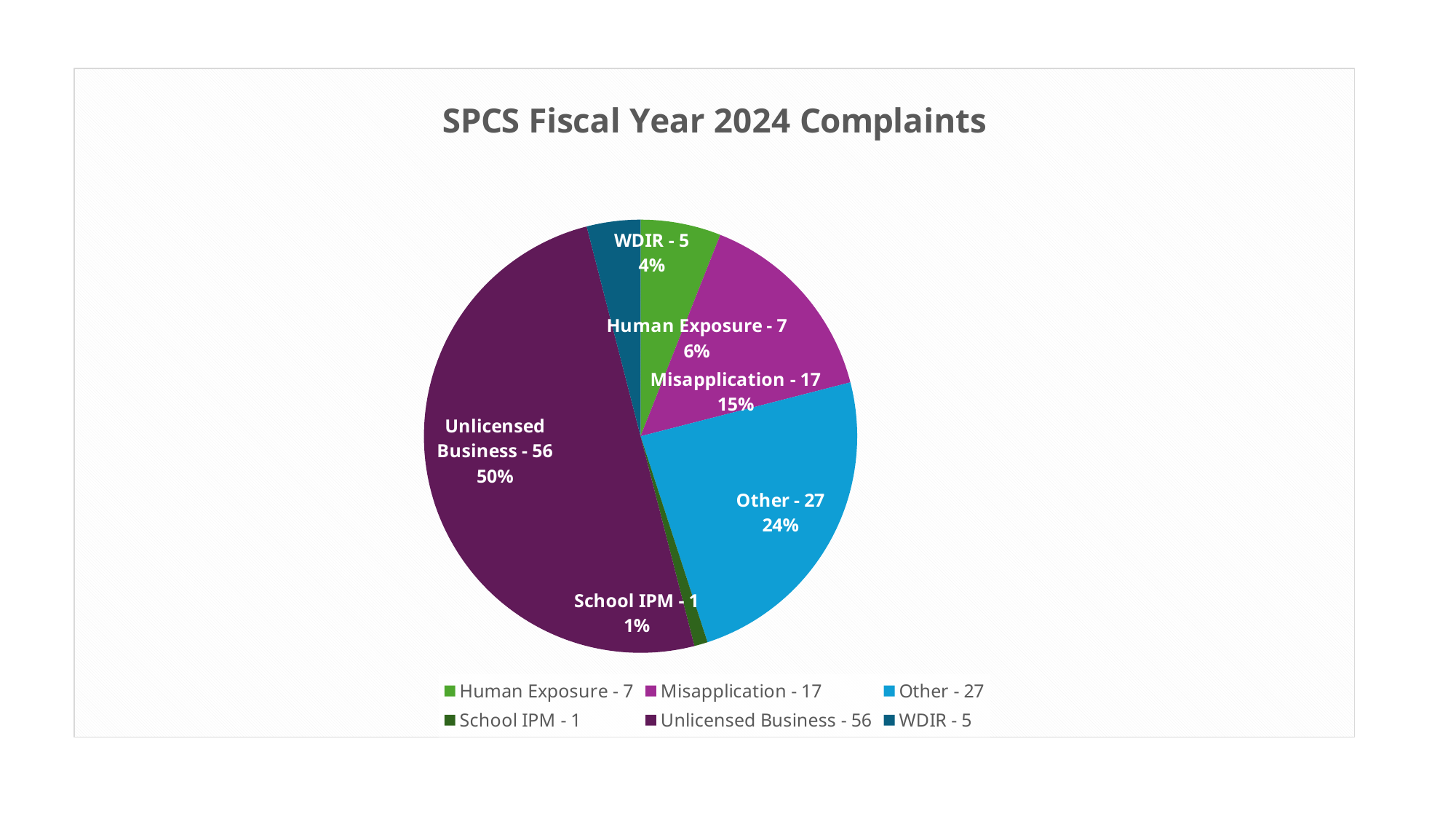
What kind of chart is shown on the slide? Pie chart What percentage share of the pie does Unlicensed Business represent? 50% How many complaints are shown for Misapplication? 17 What is the title of the chart? SPCS Fiscal Year 2024 Complaints How many categories does the pie chart show? 6 How many complaints are shown for WDIR? 5 Which has more complaints, Human Exposure or WDIR? Human Exposure Which category has the smallest slice of the pie? School IPM What colour is the slice for Other? Light blue What percentage share of the pie does Other represent? 24% Which category has the largest slice of the pie? Unlicensed Business What is the difference between the number of complaints for Unlicensed Business and Other? 29